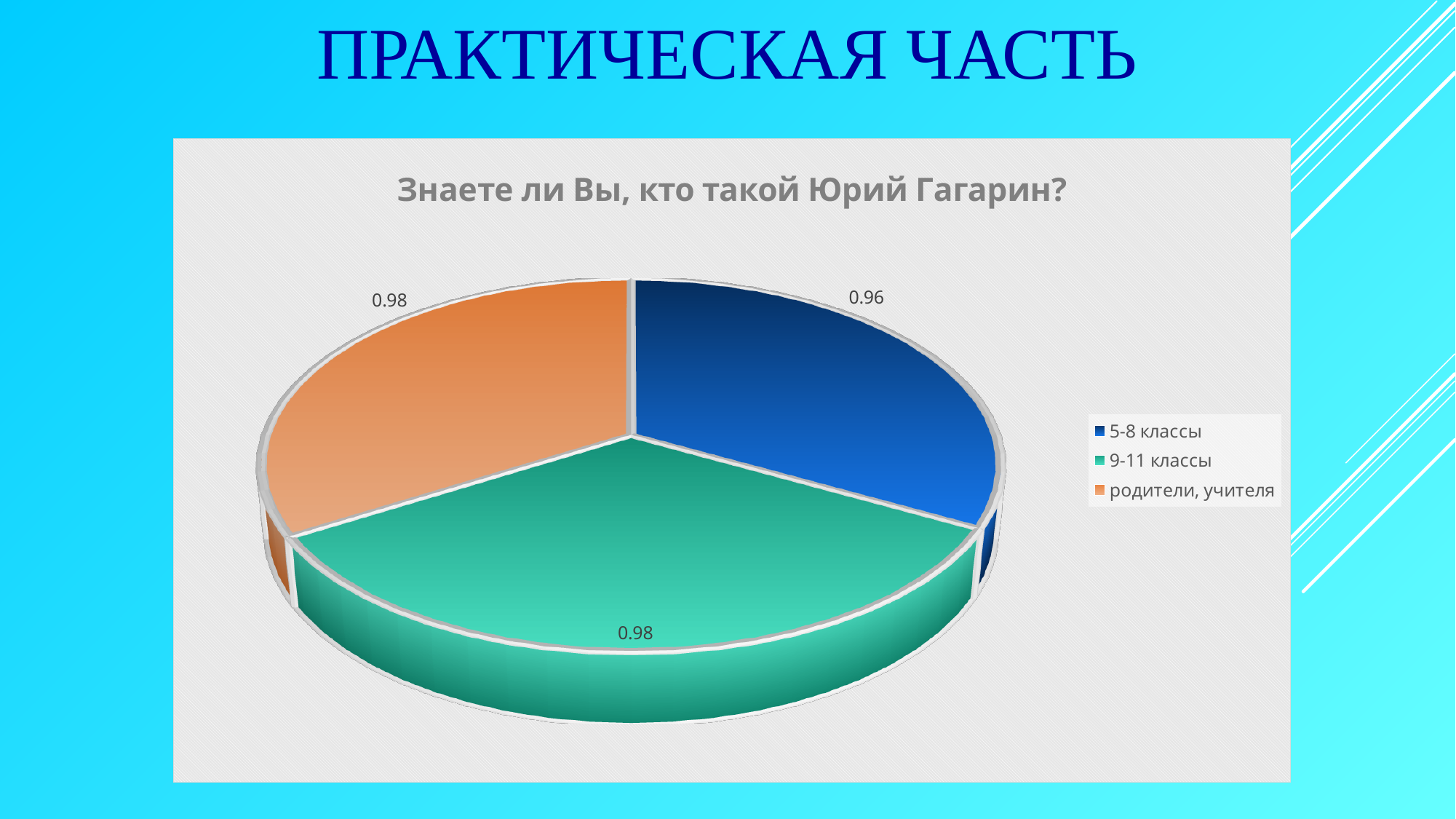
What is the value shown for родители, учителя? 0.98 What is the difference between the values for 9-11 классы and 5-8 классы? 0.02 What is the value shown for 5-8 классы? 0.96 What is the title of the chart? Знаете ли Вы, кто такой Юрий Гагарин? How many slices does the pie chart have? 3 Which colour represents 9-11 классы in the chart? Green Which is larger, the value for родители, учителя or the value for 5-8 классы? родители, учителя Which category has the lowest value in the pie chart? 5-8 классы How many entries does the legend list? 3 What is the value shown for 9-11 классы? 0.98 What kind of chart is shown on the slide? Pie chart